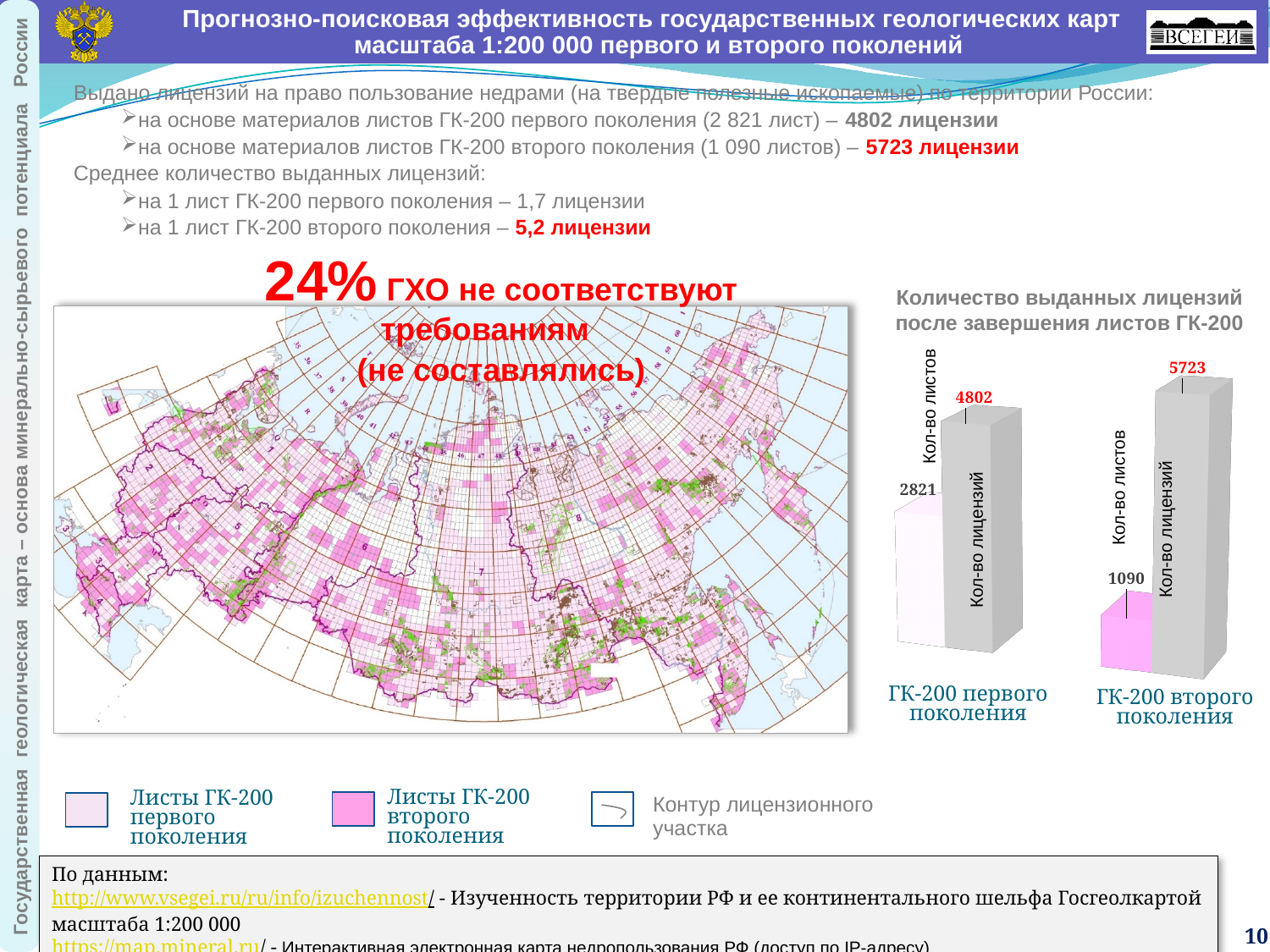
What is the title of the bar chart on the right side of the slide? Количество выданных лицензий после завершения листов ГК-200 In the chart 'Количество выданных лицензий после завершения листов ГК-200', what is the value of 'Кол-во листов' for 'ГК-200 второго поколения'? 1090 In the chart 'Количество выданных лицензий после завершения листов ГК-200', what is the value of 'Кол-во лицензий' for 'ГК-200 первого поколения'? 4802 In the chart 'Количество выданных лицензий после завершения листов ГК-200', what is the difference in 'Кол-во листов' between 'ГК-200 первого поколения' and 'ГК-200 второго поколения'? 1731 What type of chart is shown on the right side of the slide? bar chart In the chart 'Количество выданных лицензий после завершения листов ГК-200', what is the value of 'Кол-во лицензий' for 'ГК-200 второго поколения'? 5723 In the chart 'Количество выданных лицензий после завершения листов ГК-200', what is the difference in 'Кол-во лицензий' between 'ГК-200 второго поколения' and 'ГК-200 первого поколения'? 921 In the chart 'Количество выданных лицензий после завершения листов ГК-200', which category has the higher 'Кол-во лицензий' value? ГК-200 второго поколения In the chart 'Количество выданных лицензий после завершения листов ГК-200', is 'Кол-во листов' for 'ГК-200 первого поколения' larger or smaller than 'Кол-во лицензий' for the same category? smaller In the chart 'Количество выданных лицензий после завершения листов ГК-200', what is the value of 'Кол-во листов' for 'ГК-200 первого поколения'? 2821 How many categories are shown on the x axis of the chart 'Количество выданных лицензий после завершения листов ГК-200'? 2 In the chart 'Количество выданных лицензий после завершения листов ГК-200', which category has the lower 'Кол-во листов' value? ГК-200 второго поколения